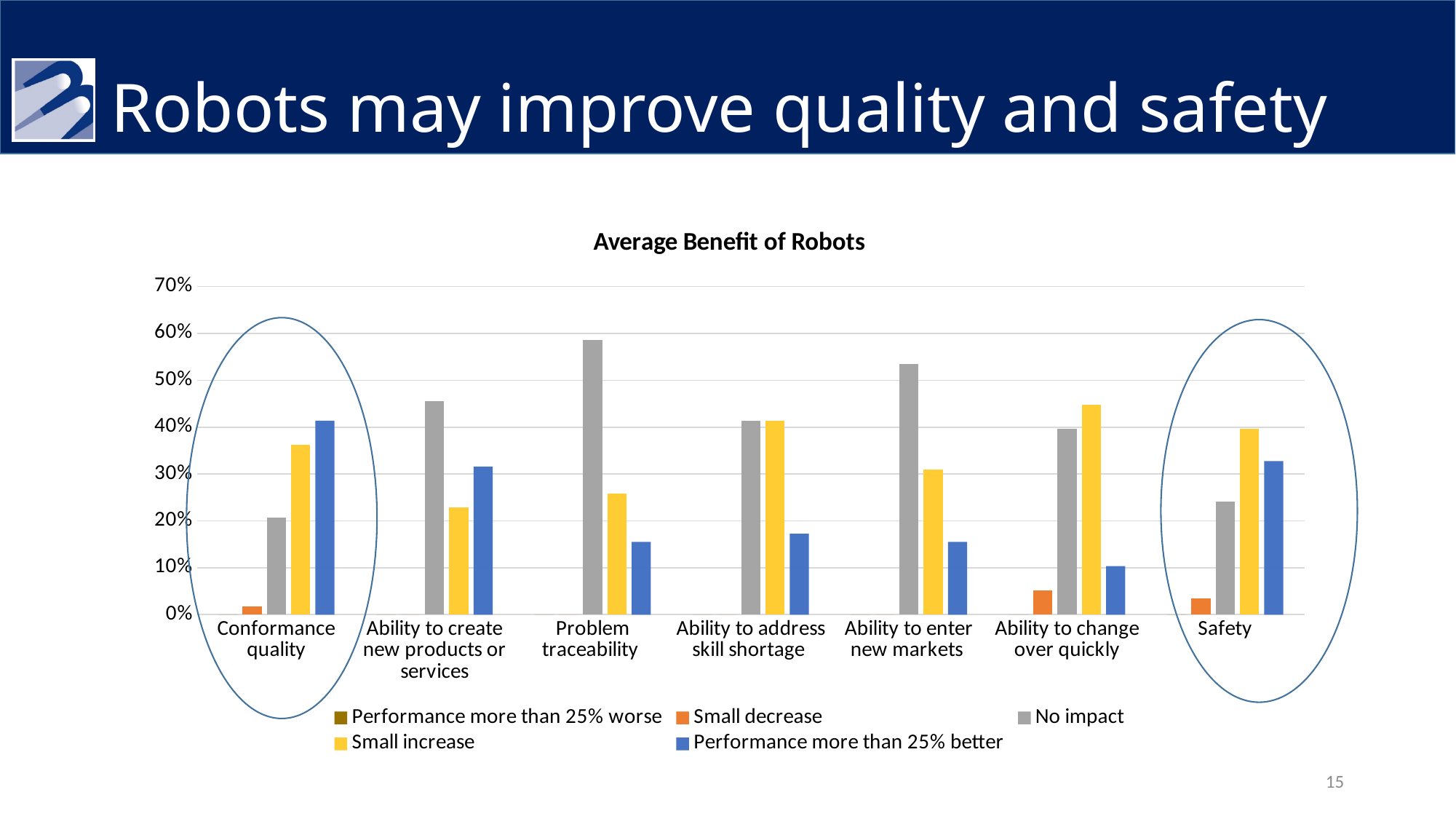
For Conformance quality, which is larger: 'Small increase' or 'Performance more than 25% better'? Performance more than 25% better Which two categories on the chart are circled? Conformance quality and Safety How many categories are shown along the x axis of the chart? 7 What type of chart is shown on the slide? Bar chart Is the 'Small increase' value for Ability to change over quickly greater or less than 40%? greater Which category has the highest 'No impact' bar? Problem traceability Which category has the highest 'Performance more than 25% better' bar? Conformance quality What is the title of the chart? Average Benefit of Robots Is the 'No impact' value for Problem traceability greater or less than 50%? greater Which category has the lowest 'Performance more than 25% better' bar? Ability to change over quickly How many series does the legend of the chart list? 5 Is the 'Performance more than 25% better' value for Ability to change over quickly greater or less than 20%? less